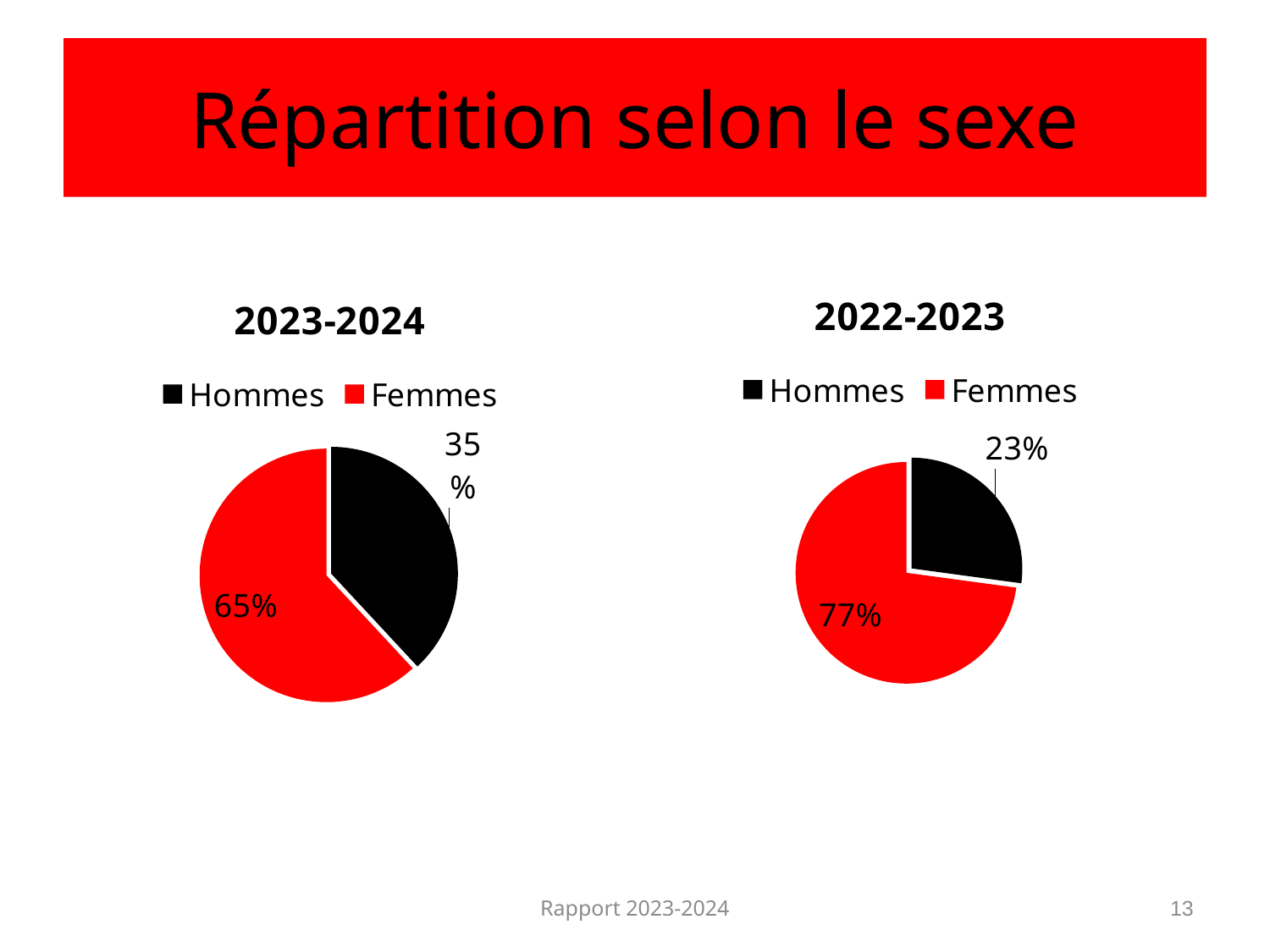
In the 2022-2023 chart, what is the difference between the Femmes and Hommes shares? 54% How many categories does the legend of the 2023-2024 chart list? 2 In the 2023-2024 chart, which category has the largest slice? Femmes In the 2022-2023 chart, which category has the smallest slice? Hommes In the 2023-2024 chart, what share of the pie is Femmes? 65% In the 2022-2023 chart, what colour is the Femmes slice? Red In the 2022-2023 chart, what share of the pie is Hommes? 23% In the 2023-2024 chart, what is the difference between the Femmes and Hommes shares? 30% In the 2022-2023 chart, what share of the pie is Femmes? 77% What kind of chart is the 2022-2023 chart? Pie chart Is the Hommes share larger in the 2023-2024 chart or the 2022-2023 chart? 2023-2024